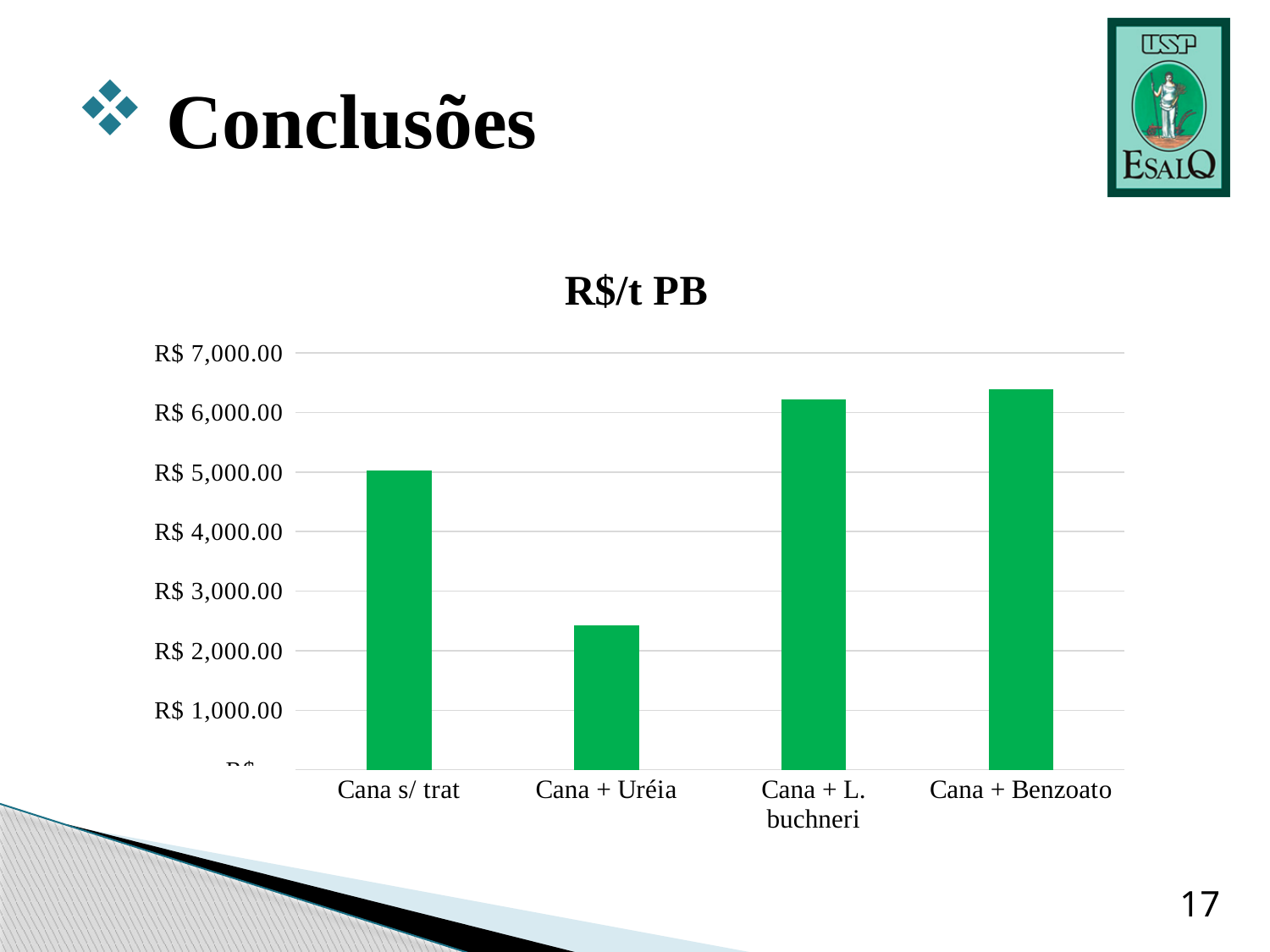
Is the value for Cana s/ trat greater or less than R$ 4,000.00? greater Is the value for Cana + L. buchneri greater or less than R$ 6,000.00? greater What colour are the bars in the chart? green Is the value for Cana + Uréia greater or less than R$ 2,000.00? greater How many categories are plotted in the chart? 4 What is the title of the chart? R$/t PB Which category has the lowest value in the chart? Cana + Uréia Which is larger, the value for Cana s/ trat or the value for Cana + Uréia? Cana s/ trat What kind of chart is shown on the slide? bar chart Which category has the highest value in the chart? Cana + Benzoato